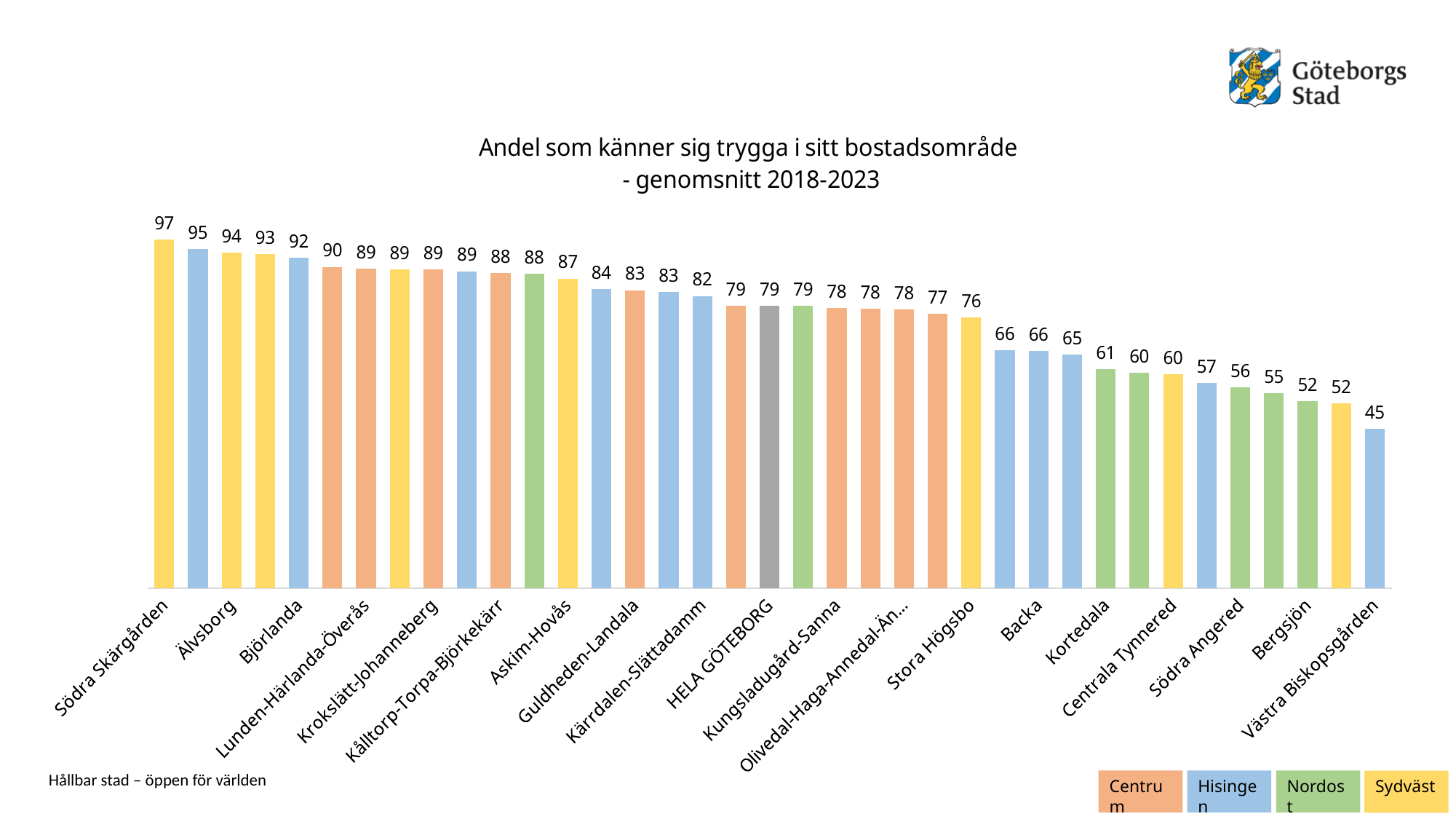
What kind of chart is shown? Bar chart Do the values rise or fall from left to right along the x axis? Fall What is the difference between the values for Södra Skärgården and Västra Biskopsgården? 52 Which area has the highest value? Södra Skärgården What is the value for Bergsjön? 52 What is the value for Södra Skärgården? 97 What is the value for Västra Biskopsgården? 45 What is the value for Backa? 66 Which has a larger value, Björlanda or Askim-Hovås? Björlanda Which area has the lowest value? Västra Biskopsgården What is the value for HELA GÖTEBORG? 79 How many entries does the legend list? 4